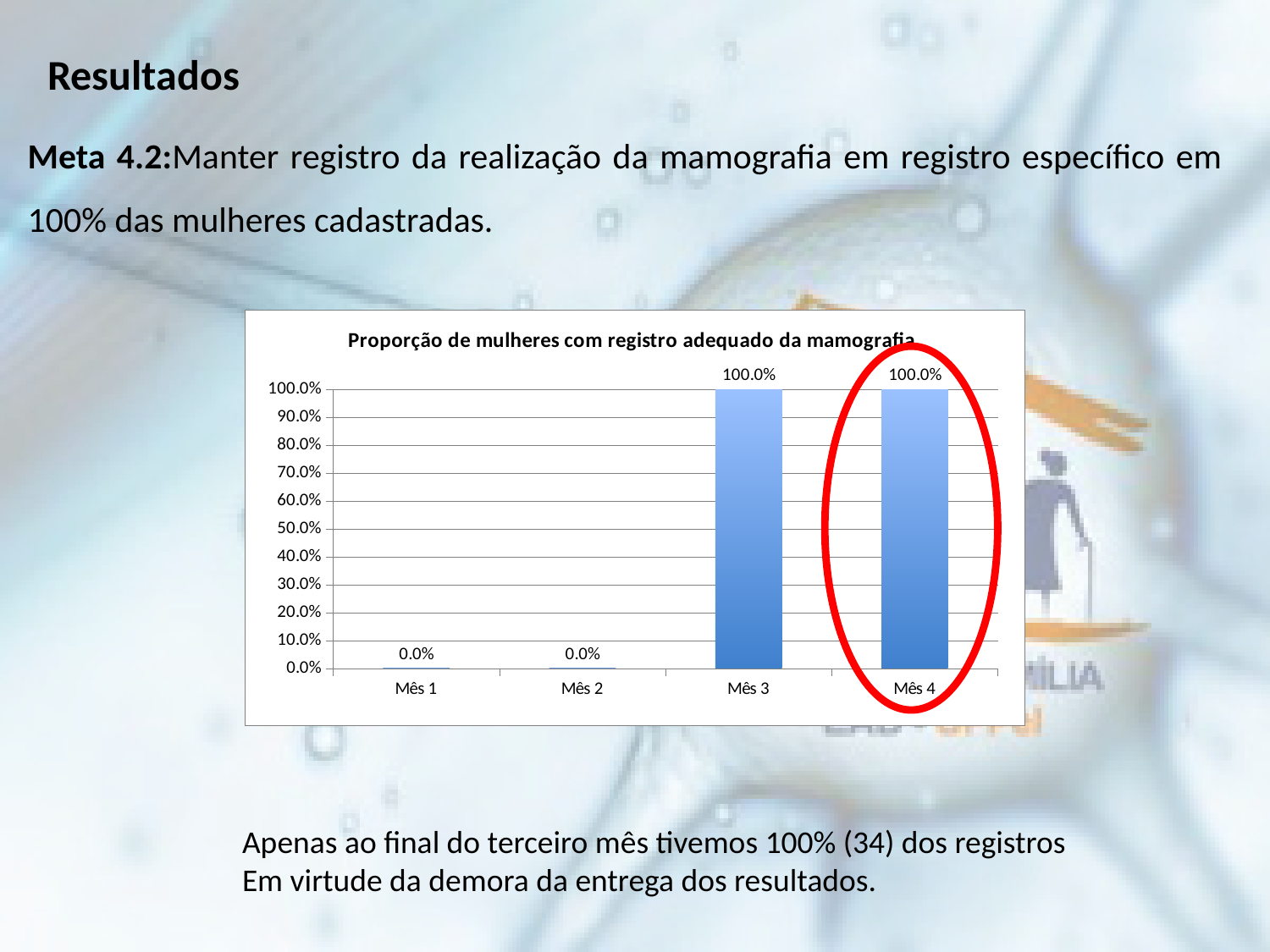
What is the value for Mês 1? 0.0% Which of Mês 2 and Mês 3 has the larger value? Mês 3 What kind of chart is shown on the slide? bar chart How many categories are shown on the x axis? 4 Is the value for Mês 3 greater or less than 50.0%? greater What is the value for Mês 3? 100.0% What is the value for Mês 4? 100.0% Which category is circled in red on the chart? Mês 4 What is the value for Mês 2? 0.0% Do the values rise or fall from Mês 1 to Mês 4? rise What is the difference between the values for Mês 4 and Mês 1? 100.0% What is the title of the chart? Proporção de mulheres com registro adequado da mamografia